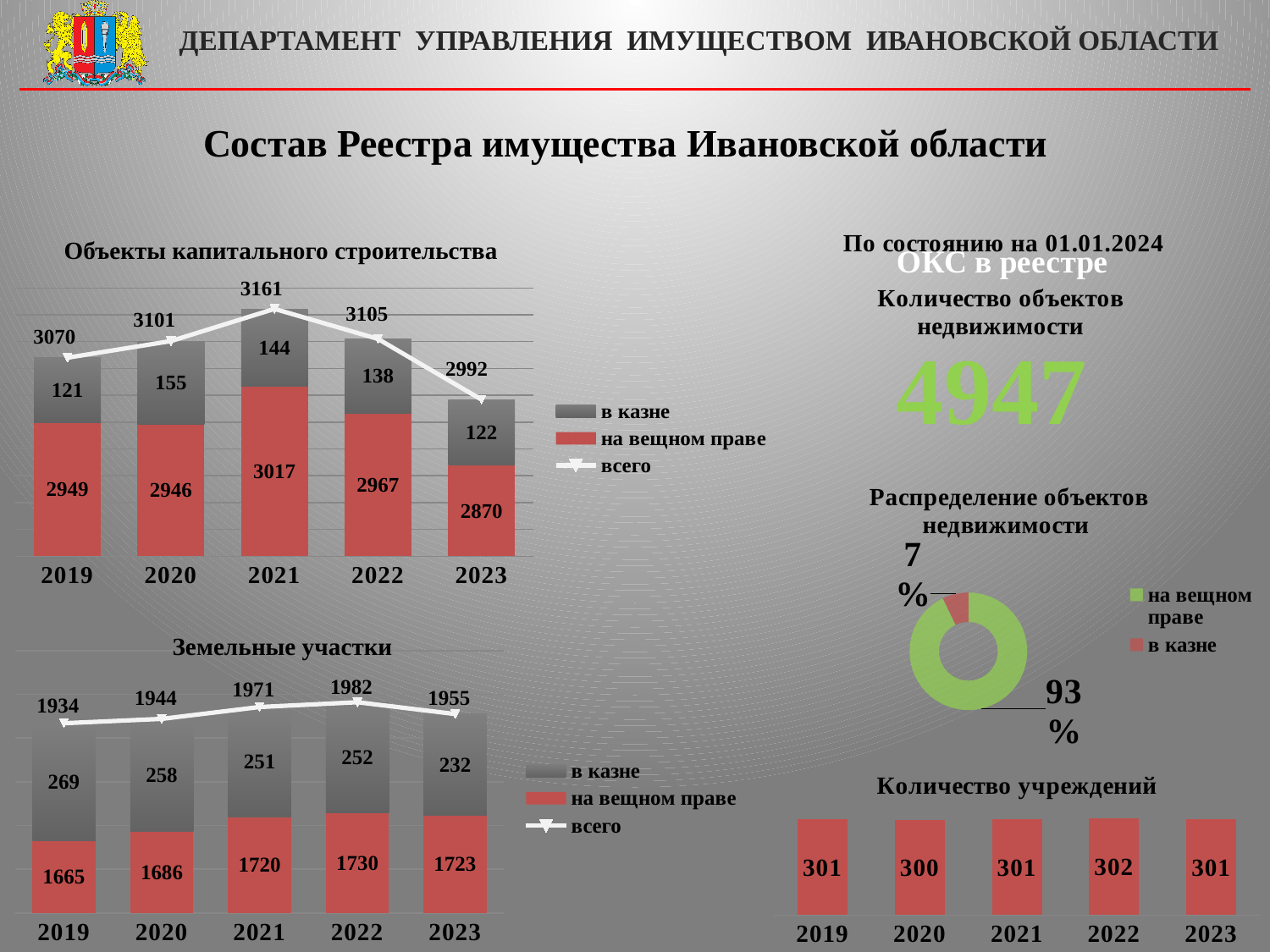
In the chart 'Объекты капитального строительства', what is the difference between the 'в казне' values for 2020 and 2019? 34 What kind of chart is 'Количество учреждений'? bar chart In the chart 'Земельные участки', what is the value for 'в казне' in 2022? 252 In the chart 'Объекты капитального строительства', what is the 'всего' value for 2023? 2992 In the chart 'Количество учреждений', how many years are shown on the x axis? 5 In the chart 'Количество учреждений', what is the value for 2022? 302 In the chart 'Земельные участки', is the 'на вещном праве' value larger in 2022 or in 2023? 2022 In the chart 'Земельные участки', how many series does the legend list? 3 In the chart 'Земельные участки', which year has the lowest 'всего' value? 2019 In the chart 'Объекты капитального строительства', what is the value for 'на вещном праве' in 2021? 3017 In the chart 'Объекты капитального строительства', which year has the highest 'всего' value? 2021 In the chart 'Распределение объектов недвижимости', what share of the pie is 'на вещном праве'? 93%